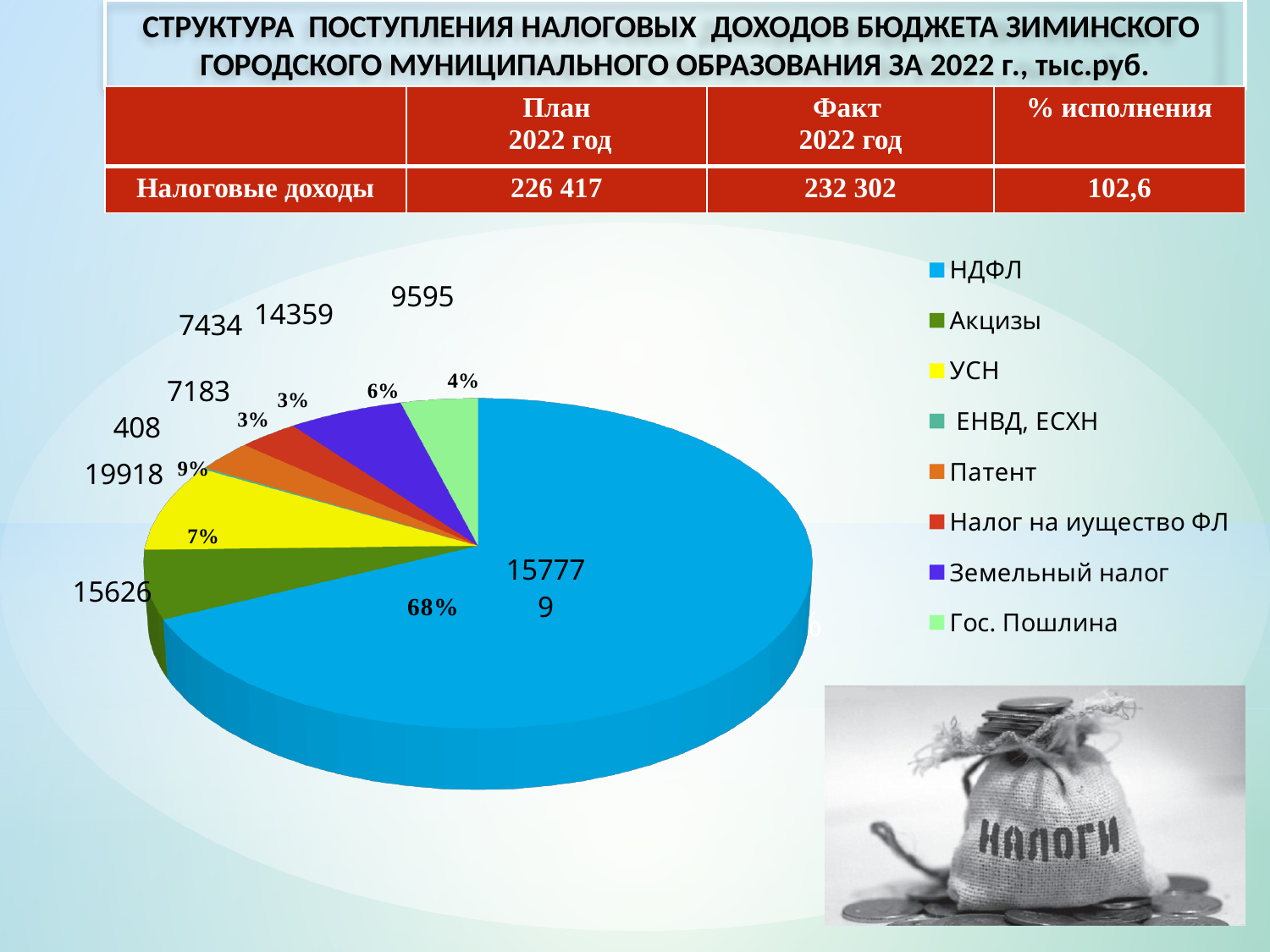
Which category has the smallest slice of the pie? ЕНВД, ЕСХН What kind of chart is shown on the slide? pie chart What is the value shown for Гос. Пошлина on the pie chart? 9595 What share of the pie does НДФЛ account for? 68% What colour is the НДФЛ slice in the pie chart? blue What is the difference between the values for УСН and Акцизы? 4292 What is the value shown for Земельный налог on the pie chart? 14359 How many categories does the legend of the pie chart list? 8 What is the value shown for УСН on the pie chart? 19918 Which is larger, the value for УСН or the value for Акцизы? УСН Which category has the largest slice of the pie? НДФЛ What share of the pie does Гос. Пошлина account for? 4%